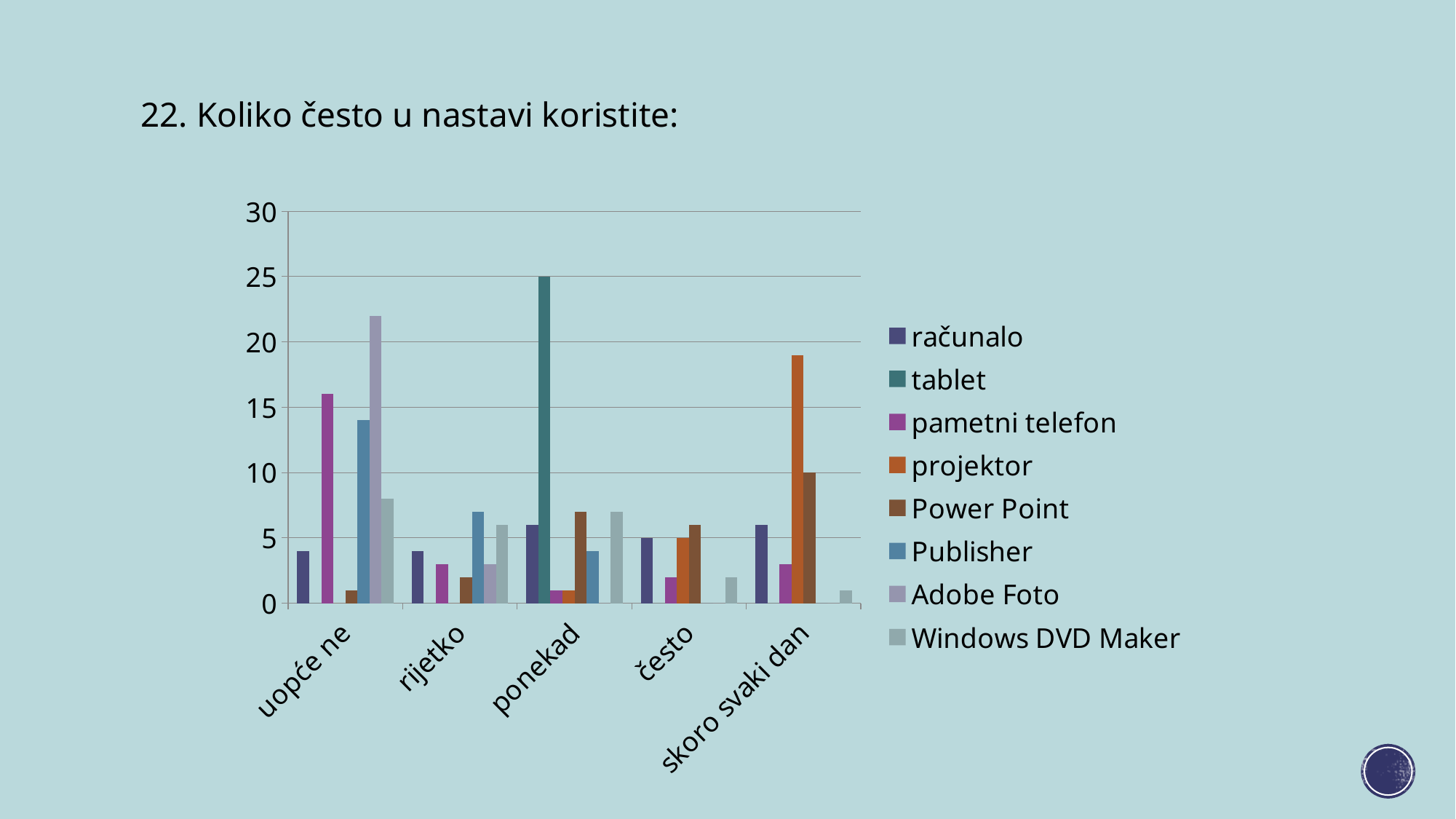
In the 'uopće ne' category, which is larger: pametni telefon or Publisher? pametni telefon What is the value for tablet in the 'ponekad' category? 25 Is the value for Adobe Foto in the 'uopće ne' category greater or less than 20? greater How many categories are shown on the x axis of the chart? 5 What kind of chart is shown on the slide? bar chart Is the value for Publisher in the 'uopće ne' category greater or less than 15? less Which series has the highest bar in the 'uopće ne' category? Adobe Foto Which series has the highest bar in the 'ponekad' category? tablet What is the title of the chart on the slide? 22. Koliko često u nastavi koristite: How many series does the chart's legend list? 8 What is the value for Power Point in the 'skoro svaki dan' category? 10 Is the value for projektor in the 'skoro svaki dan' category greater or less than 20? less